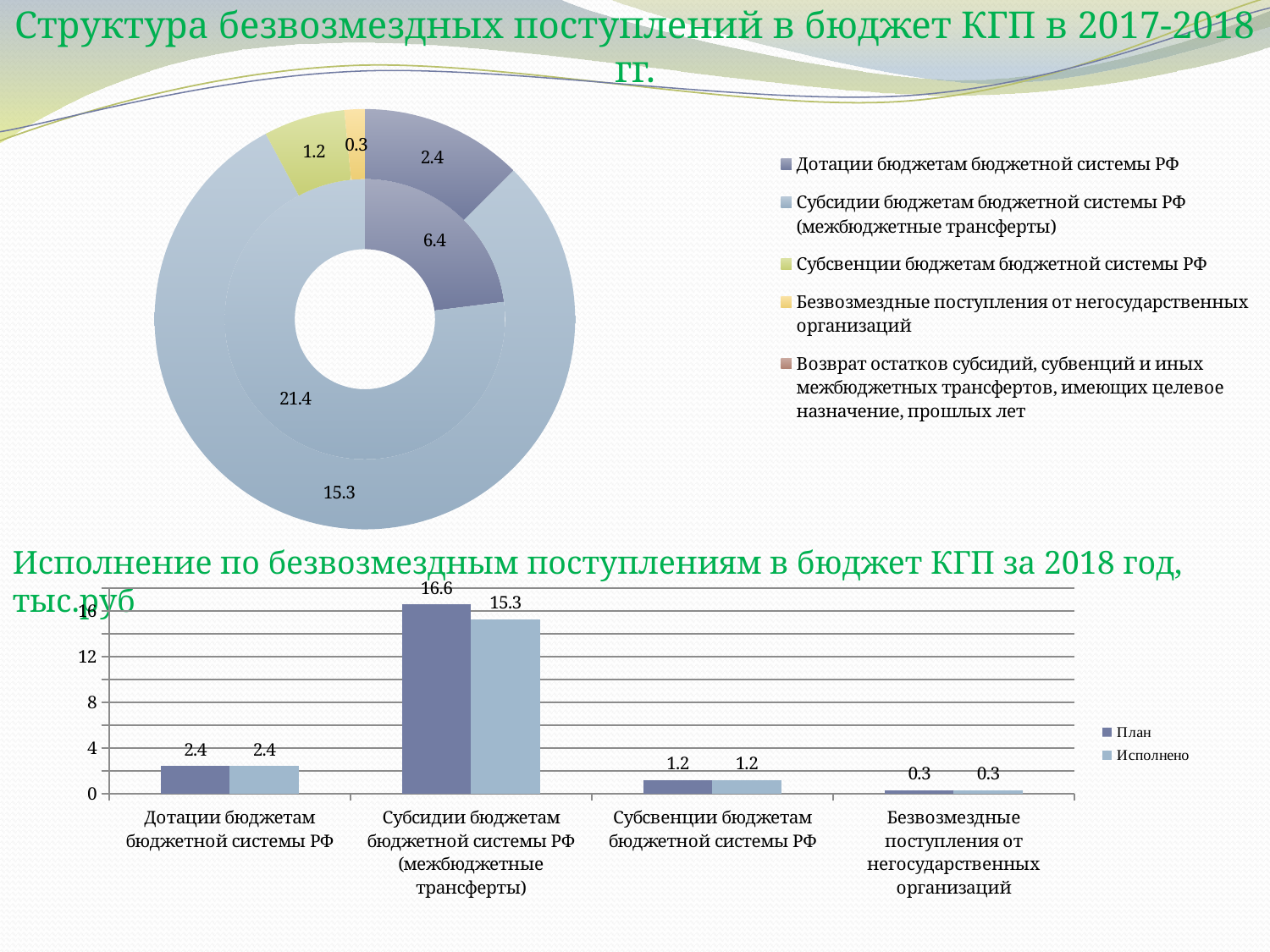
In the bottom bar chart, what is the План value for Субсидии бюджетам бюджетной системы РФ (межбюджетные трансферты)? 16.6 In the bottom bar chart, what is the Исполнено value for Дотации бюджетам бюджетной системы РФ? 2.4 In the bottom bar chart, what is the difference between the План and Исполнено values for Субсидии бюджетам бюджетной системы РФ (межбюджетные трансферты)? 1.3 In the bottom bar chart, which category has the lowest Исполнено value? Безвозмездные поступления от негосударственных организаций How many entries does the legend of the top doughnut chart list? 5 In the top doughnut chart, what is the largest value labelled on the inner ring? 21.4 In the bottom bar chart, which category has the highest План value? Субсидии бюджетам бюджетной системы РФ (межбюджетные трансферты) In the bottom bar chart, how many categories are shown on the x axis? 4 In the bottom bar chart, how many series does the legend list? 2 In the bottom bar chart, what is the Исполнено value for Субсидии бюджетам бюджетной системы РФ (межбюджетные трансферты)? 15.3 In the top doughnut chart, what is the value labelled on the outer ring for the Субсвенции бюджетам бюджетной системы РФ segment? 1.2 What kind of chart is the chart at the top of the slide? Doughnut chart